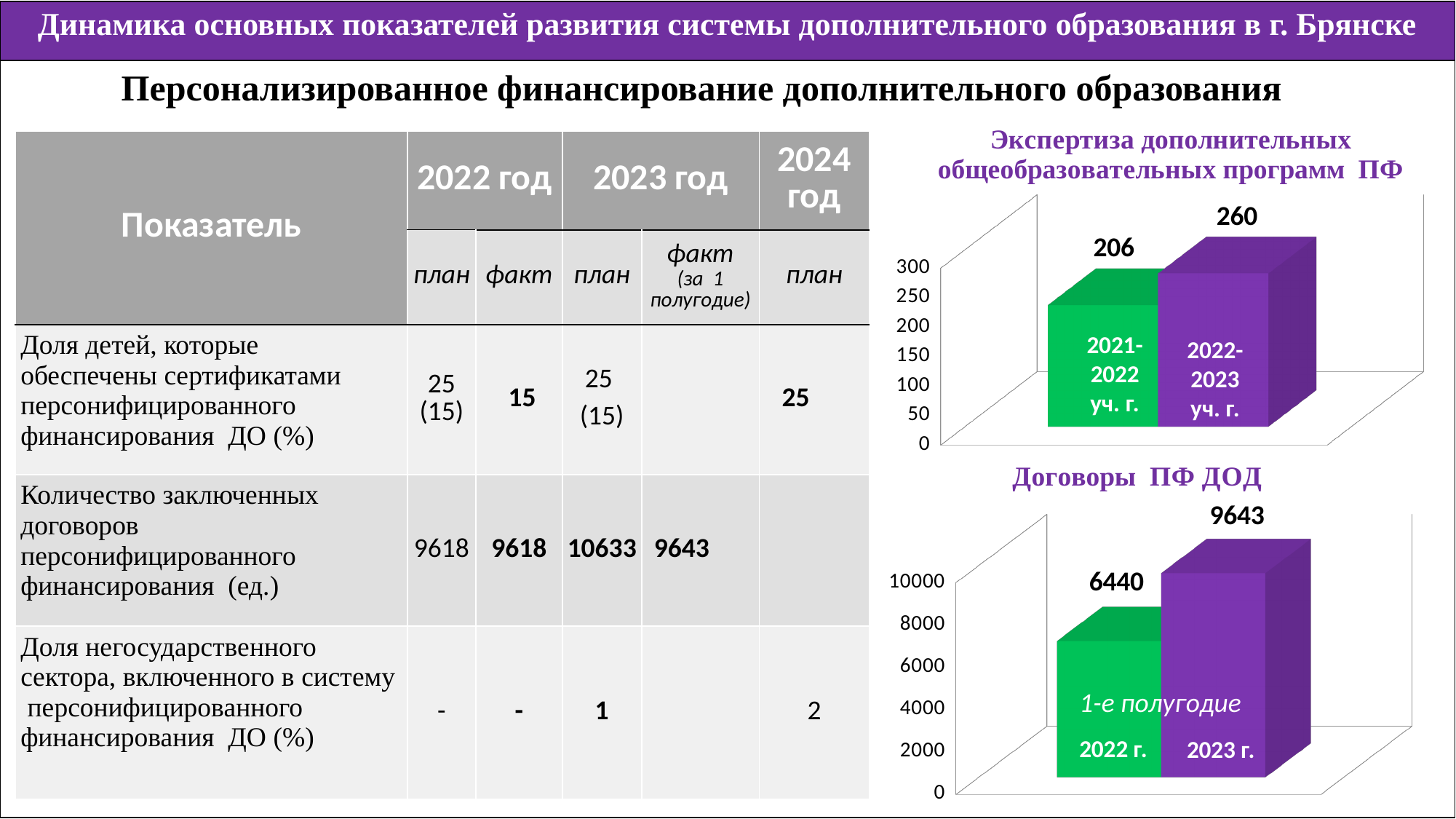
In the chart 'Экспертиза дополнительных общеобразовательных программ ПФ', which academic year has the higher value? 2022-2023 уч. г. In the chart 'Договоры ПФ ДОД', which year has the lower value? 2022 г. In the chart 'Договоры ПФ ДОД', what is the value for 2023 г.? 9643 What type of chart is 'Договоры ПФ ДОД'? bar chart In the chart 'Договоры ПФ ДОД', what is the difference between the 2023 г. and 2022 г. values? 3203 In the chart 'Экспертиза дополнительных общеобразовательных программ ПФ', what is the difference between the 2022-2023 and 2021-2022 values? 54 In the chart 'Экспертиза дополнительных общеобразовательных программ ПФ', do the values rise or fall from 2021-2022 to 2022-2023? rise In the chart 'Экспертиза дополнительных общеобразовательных программ ПФ', what is the value for 2022-2023 уч. г.? 260 In the chart 'Договоры ПФ ДОД', what is the value for 2022 г.? 6440 In the chart 'Экспертиза дополнительных общеобразовательных программ ПФ', what is the value for 2021-2022 уч. г.? 206 In the chart 'Экспертиза дополнительных общеобразовательных программ ПФ', how many bars are plotted? 2 In the chart 'Договоры ПФ ДОД', what period do the bars represent according to the label inside the bars? 1-е полугодие